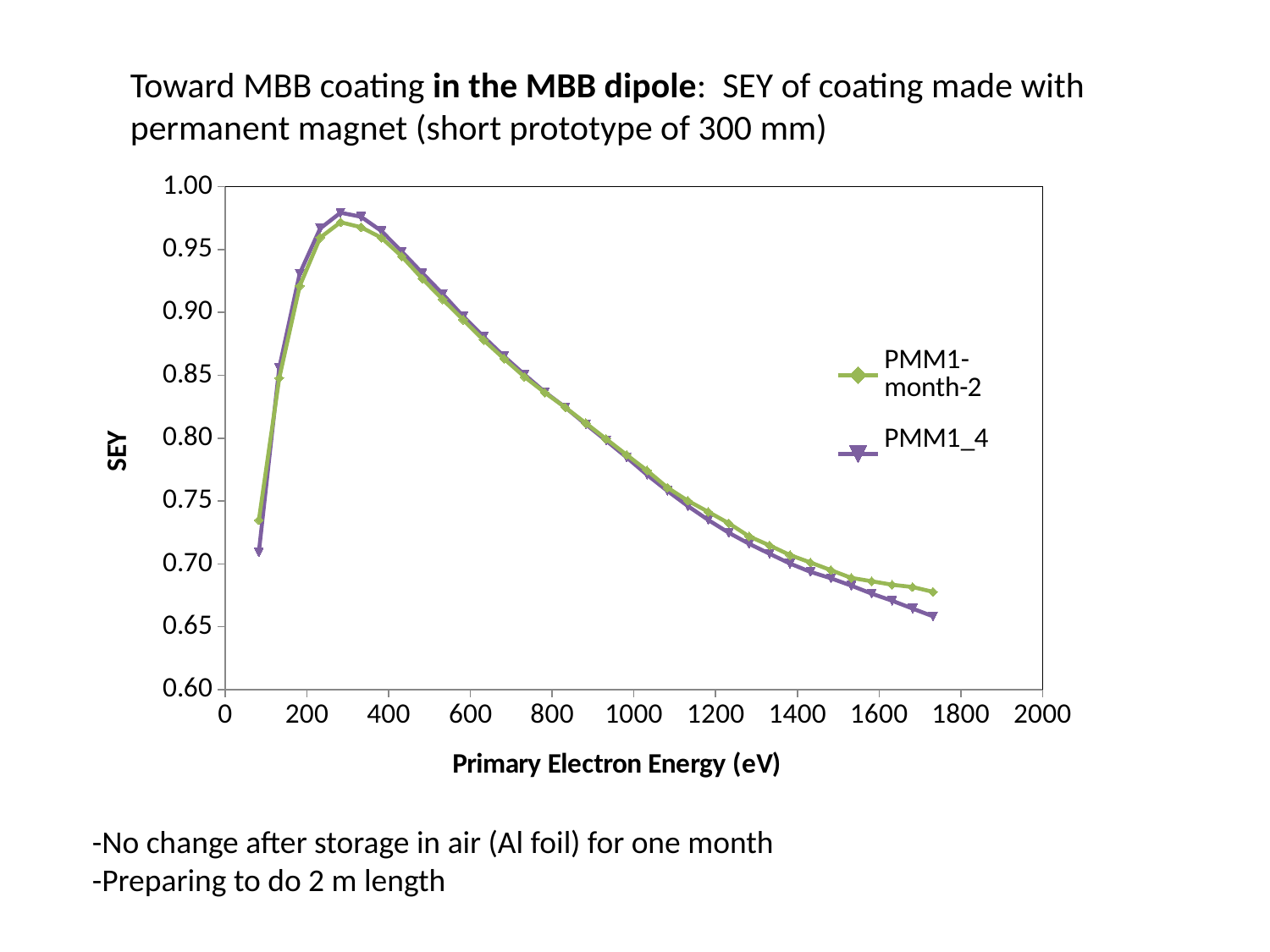
At the highest energy plotted (around 1700 eV), which series has the larger SEY, PMM1-month-2 or PMM1_4? PMM1-month-2 What kind of chart is shown on the slide? line chart At the lowest energy plotted (around 80 eV), which series has the larger SEY, PMM1-month-2 or PMM1_4? PMM1-month-2 Is the SEY of the PMM1_4 series at 1000 eV greater or less than 0.80? less Is the peak value of the PMM1-month-2 series greater or less than 0.95? greater Is the SEY of the PMM1-month-2 series at 600 eV greater or less than 0.85? greater Beyond the peak near 300 eV, do the SEY values rise or fall as primary electron energy increases? fall What is the title of the x axis? Primary Electron Energy (eV) How many series does the legend list? 2 What are the two series named in the legend? PMM1-month-2 and PMM1_4